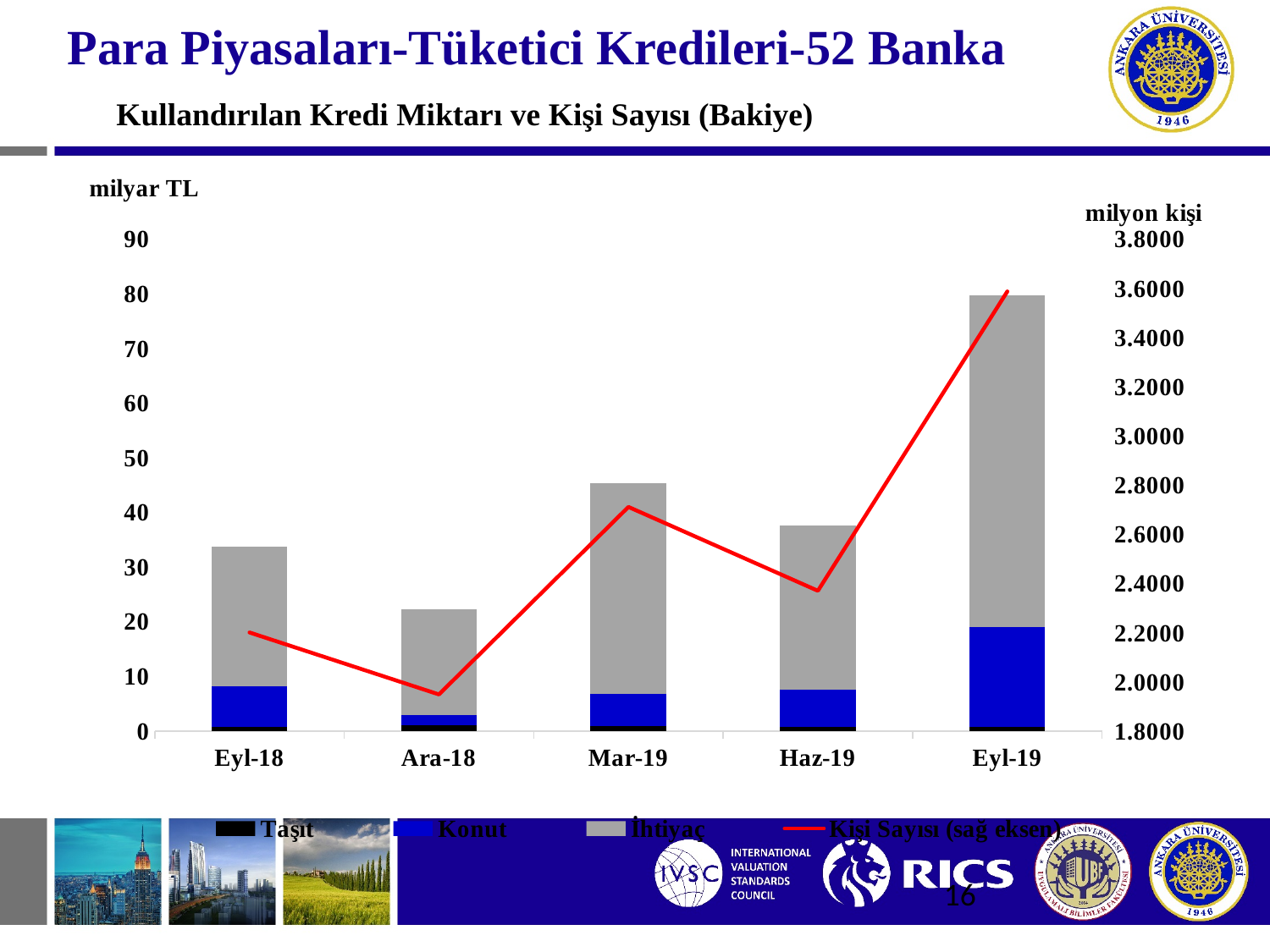
What kind of chart is shown on the slide? A stacked bar chart combined with a line Which series in the legend is plotted on the right-hand axis? Kişi Sayısı (sağ eksen) Is the total stacked bar for Eyl-19 greater or less than 70 milyar TL? greater Which period has the shortest stacked bar (lowest total credit amount)? Ara-18 Is the total stacked bar for Ara-18 greater or less than 30 milyar TL? less In which period does the Kişi Sayısı line reach its lowest point? Ara-18 How many series does the chart legend list? 4 Is the Kişi Sayısı value for Eyl-19 greater or less than 3.4000 milyon kişi? greater Which has the taller stacked bar, Mar-19 or Haz-19? Mar-19 How many time periods are shown on the x axis of the chart? 5 In which period does the Kişi Sayısı line reach its highest point? Eyl-19 Which period has the tallest stacked bar (highest total credit amount)? Eyl-19